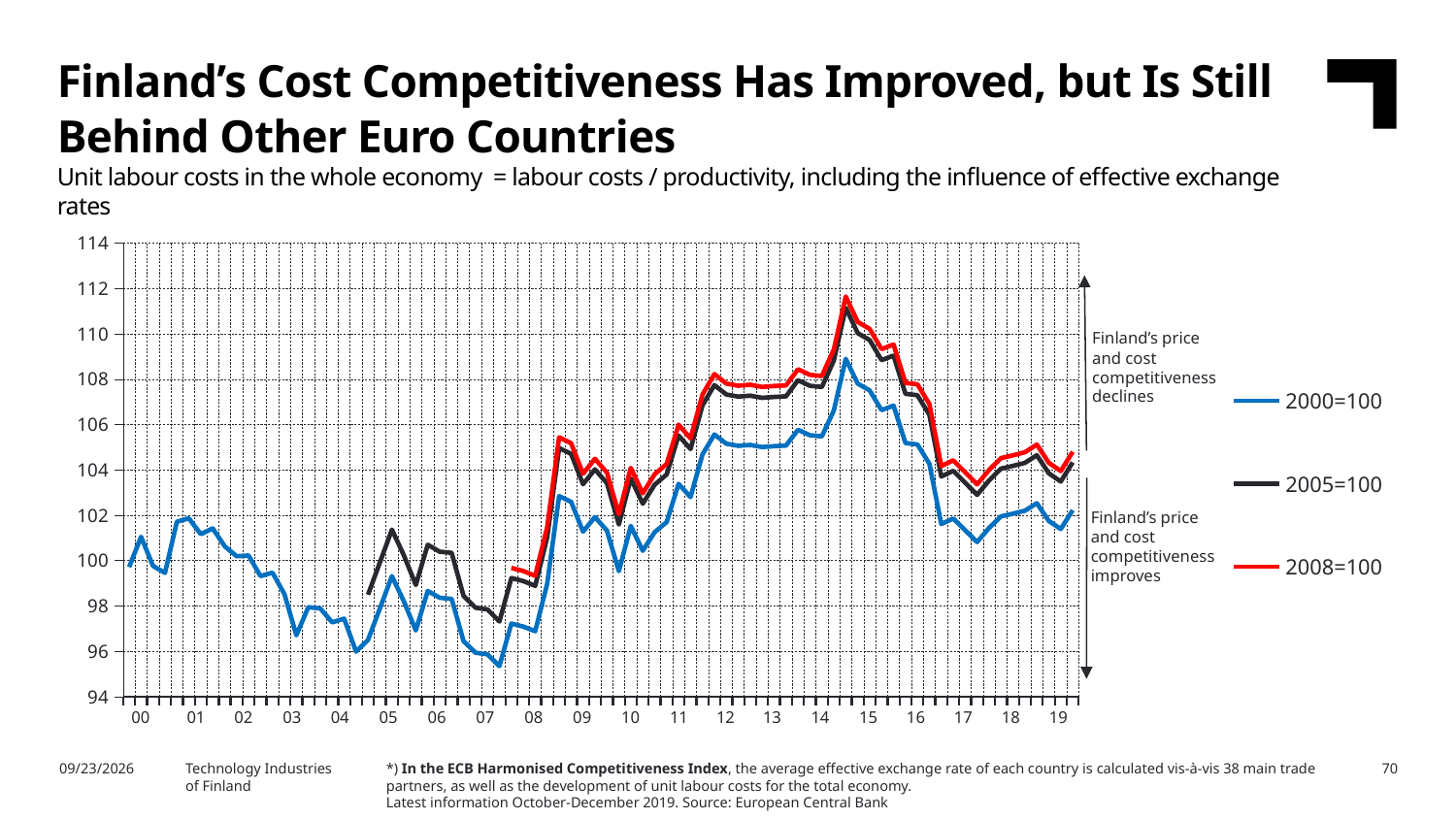
Is the peak value of the 2008=100 series around 2014–2015 greater or less than 110? greater Is the lowest value of the 2000=100 series greater or less than 98? less What colour is the 2005=100 line? Black Do the values of the series rise or fall between 2015 and 2017? Fall Is the value of the 2000=100 series at the start of 2000 greater or less than 104? less Which series reaches the lowest value on the chart? 2000=100 What are the three series named in the legend? 2000=100, 2005=100, 2008=100 What kind of chart is shown on the slide? Line chart How many series does the legend list? 3 How many years are labelled along the x axis? 20 Around 2015, which series is higher, 2008=100 or 2000=100? 2008=100 Which series reaches the highest value on the chart? 2008=100